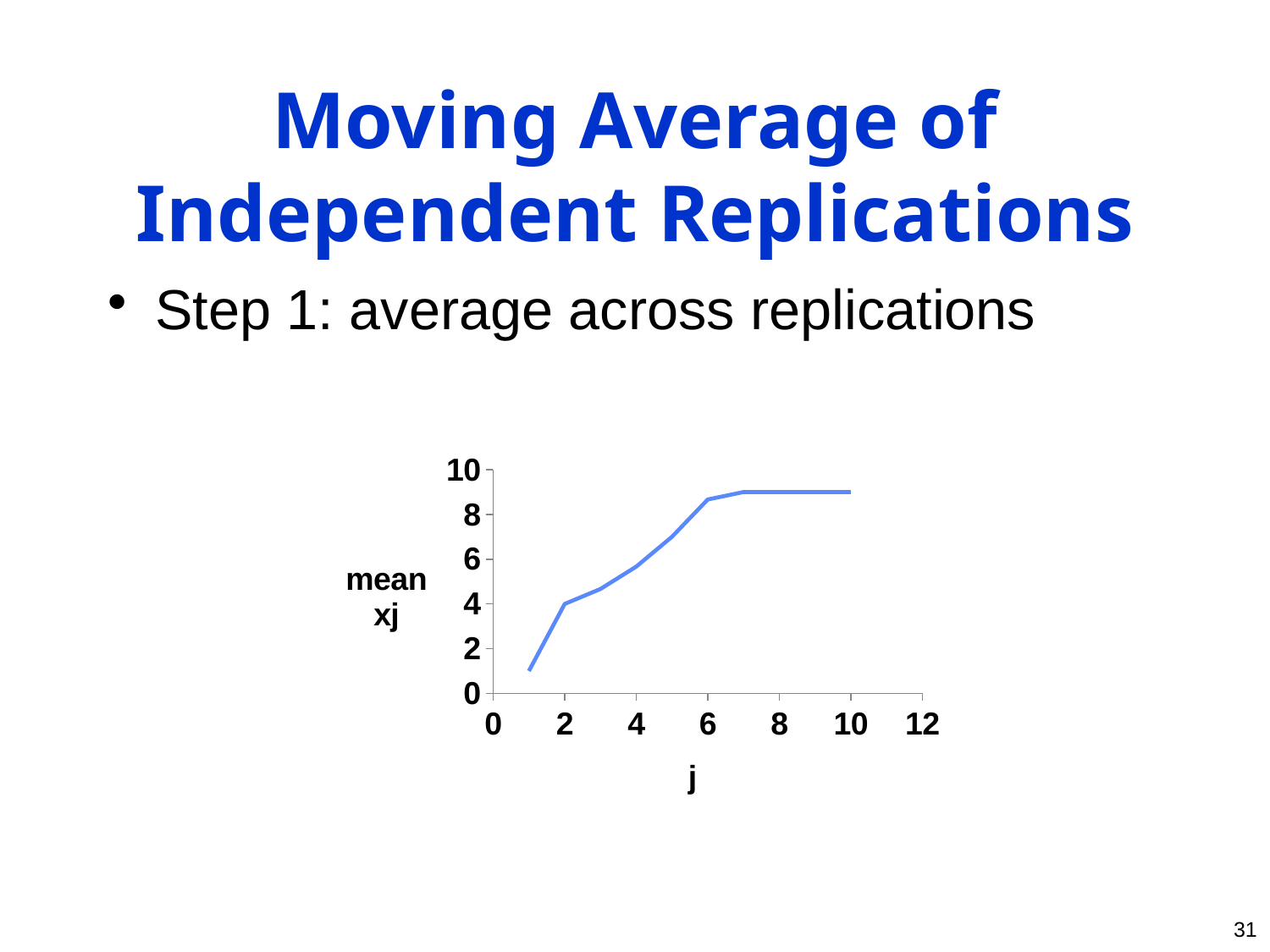
Which is larger, mean xj at j = 6 or at j = 2? j = 6 Is the value of mean xj at j = 1 greater or less than 2? less What is the label of the y axis? mean xj What kind of chart is shown on the slide? line chart What is the value of mean xj at j = 2? 4 At which value of j is mean xj lowest? 1 Is the value of mean xj at j = 4 greater or less than 4? greater Do the values of mean xj rise or fall as j increases? rise What is the label of the x axis? j Is the value of mean xj at j = 3 greater or less than 6? less